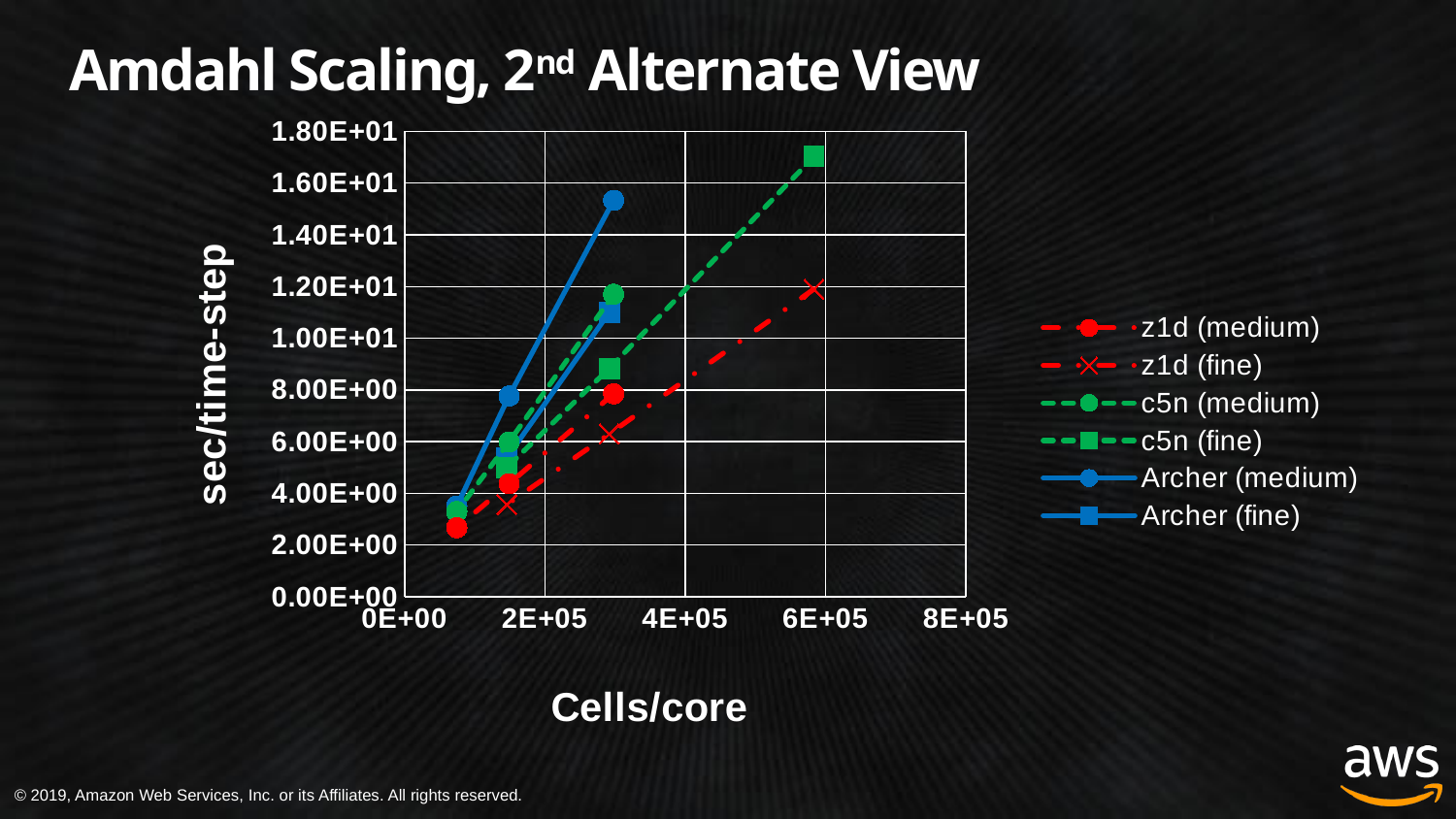
What kind of chart is shown on the slide? line chart What is the title of the chart? Amdahl Scaling, 2nd Alternate View At 3E+05 cells/core, which is larger: Archer (medium) or z1d (medium)? Archer (medium) Which series reaches the highest sec/time-step value on the chart? c5n (fine) Which series has the lowest sec/time-step values across the chart? z1d (medium) Is the value for z1d (medium) at 3E+05 cells/core greater or less than 6.00E+00? greater How many series does the legend list? 6 Is the value for z1d (fine) at 6E+05 cells/core greater or less than 1.00E+01? greater Do the sec/time-step values rise or fall as cells/core increases? rise Is the highest value for c5n (fine) greater or less than 1.60E+01? greater What is the label on the x axis? Cells/core